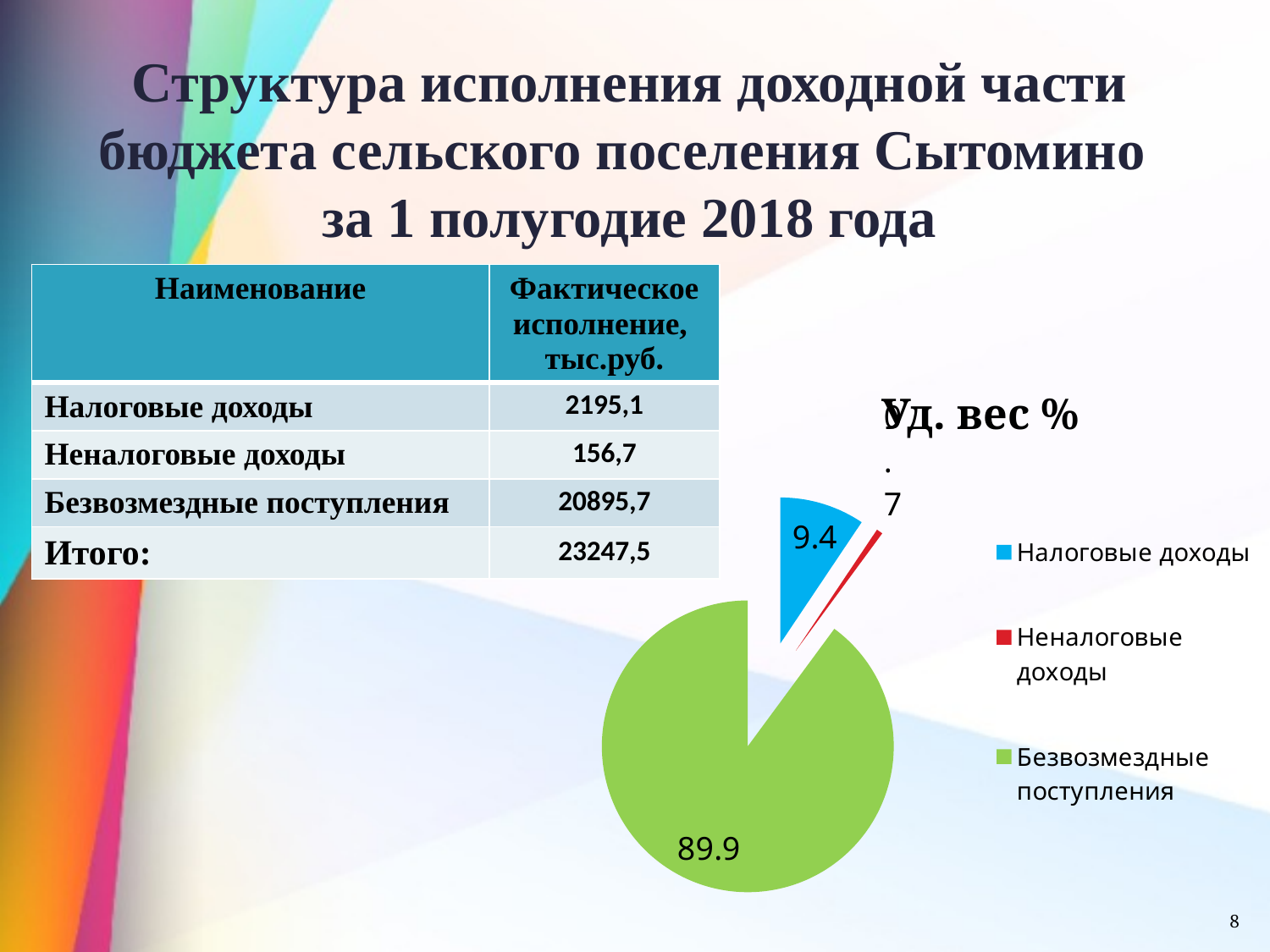
What is the title of the pie chart? Уд. вес % Which category has the smallest slice in the pie chart? Неналоговые доходы What kind of chart is shown on the slide? pie chart What colour is the Безвозмездные поступления slice in the pie chart? green How many categories does the pie chart's legend list? 3 What is the difference between the values for Безвозмездные поступления and Налоговые доходы in the pie chart? 80.5 What value is shown for Налоговые доходы in the pie chart? 9.4 Is the value for Налоговые доходы in the pie chart greater or less than 50? less What value is shown for Безвозмездные поступления in the pie chart? 89.9 In the pie chart, which is larger: Налоговые доходы or Безвозмездные поступления? Безвозмездные поступления Which category has the largest slice in the pie chart? Безвозмездные поступления